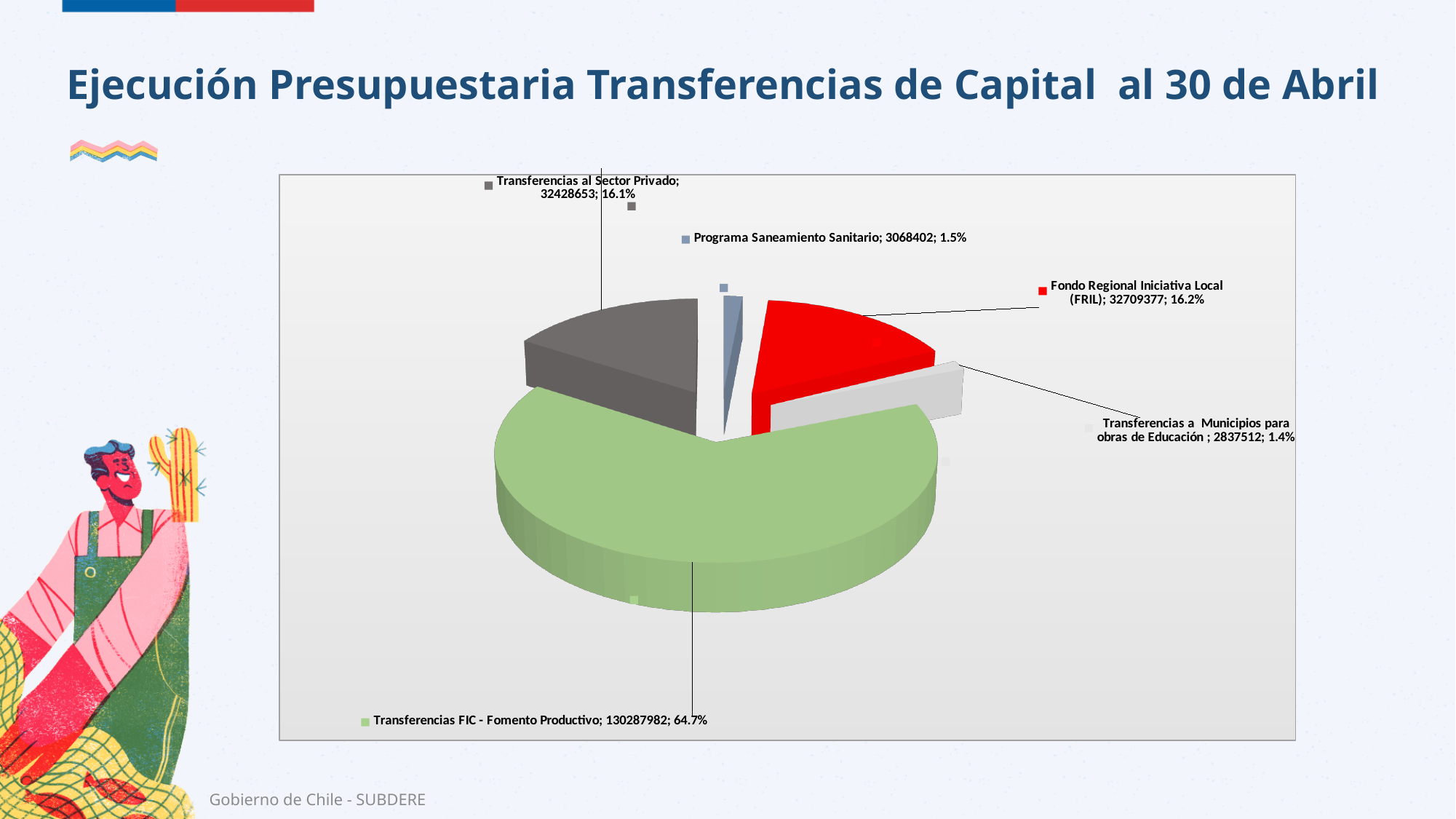
How many slices does the pie chart have? 5 What is the value for Transferencias FIC - Fomento Productivo? 130287982 What is the title of the slide containing the chart? Ejecución Presupuestaria Transferencias de Capital al 30 de Abril What share of the pie does Transferencias a Municipios para obras de Educación represent? 1.4% What is the difference between the values for Fondo Regional Iniciativa Local (FRIL) and Transferencias al Sector Privado? 280724 What kind of chart is shown on the slide? Pie chart Which category has the largest slice of the pie? Transferencias FIC - Fomento Productivo What share of the pie does Transferencias al Sector Privado represent? 16.1% Which has a larger value, Programa Saneamiento Sanitario or Transferencias a Municipios para obras de Educación? Programa Saneamiento Sanitario What is the value for Fondo Regional Iniciativa Local (FRIL)? 32709377 Which category has the smallest slice of the pie? Transferencias a Municipios para obras de Educación What is the value for Programa Saneamiento Sanitario? 3068402